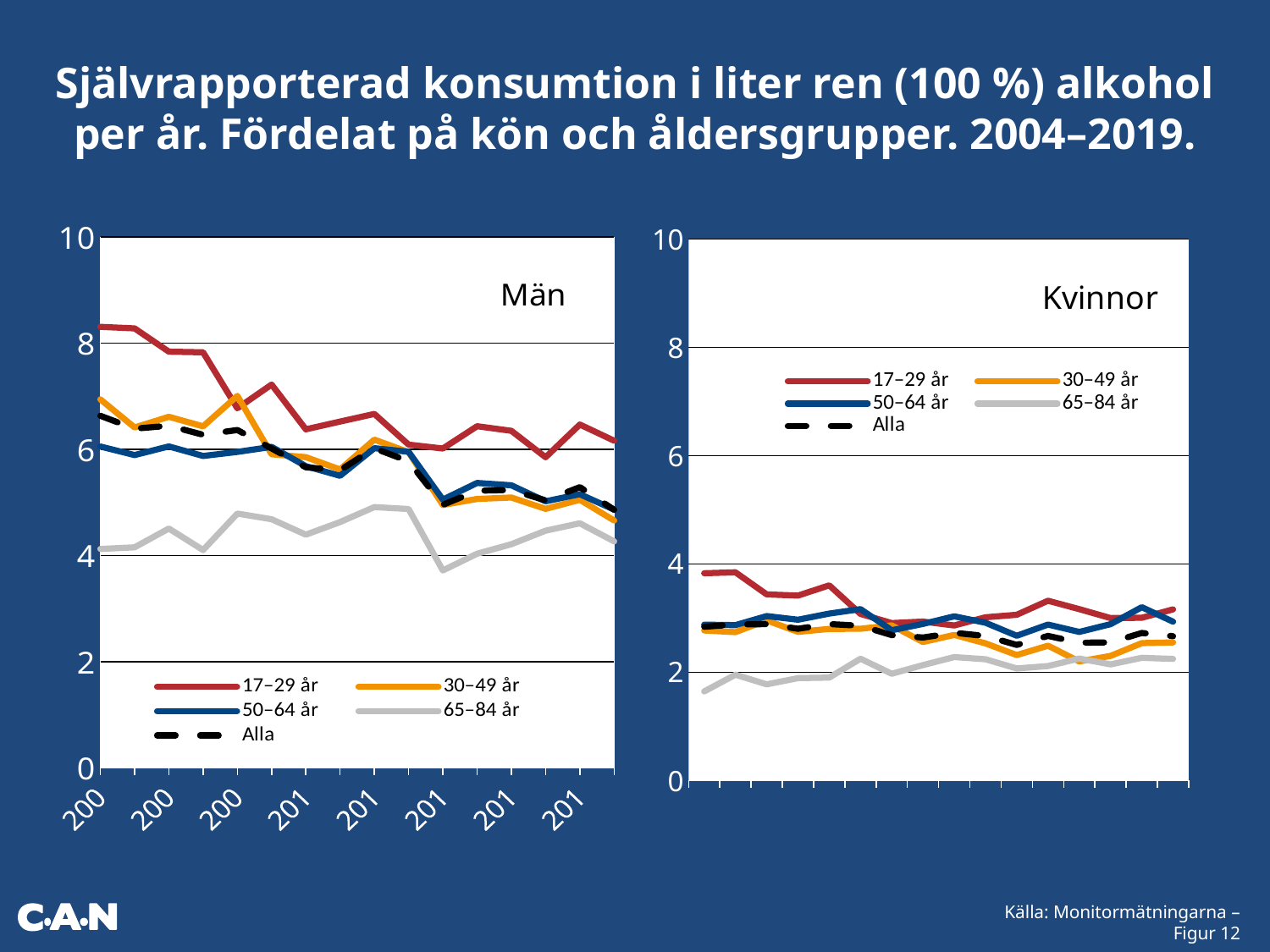
In the Män chart, does the 17–29 år line rise or fall from the start to the end of the period? fall How many series does the legend of the Kvinnor chart list? 5 In the Män chart, which is larger at the end of the period: the value for 17–29 år or the value for 65–84 år? 17–29 år In the Män chart, is the value for 17–29 år at the start of the period greater or less than 8? greater Which series is drawn as a dashed black line in both charts? Alla What kind of chart is the Män chart? line chart In the Kvinnor chart, which age group has the lowest values across the period? 65–84 år In the Kvinnor chart, is the value for 65–84 år at the start of the period greater or less than 2? less What is the maximum value shown on the y axis of the Kvinnor chart? 10 In the Män chart, which age group has the highest values across the period? 17–29 år In the Kvinnor chart, is the value for 17–29 år at the start of the period greater or less than 4? less What are the titles of the two charts on the slide? Män and Kvinnor